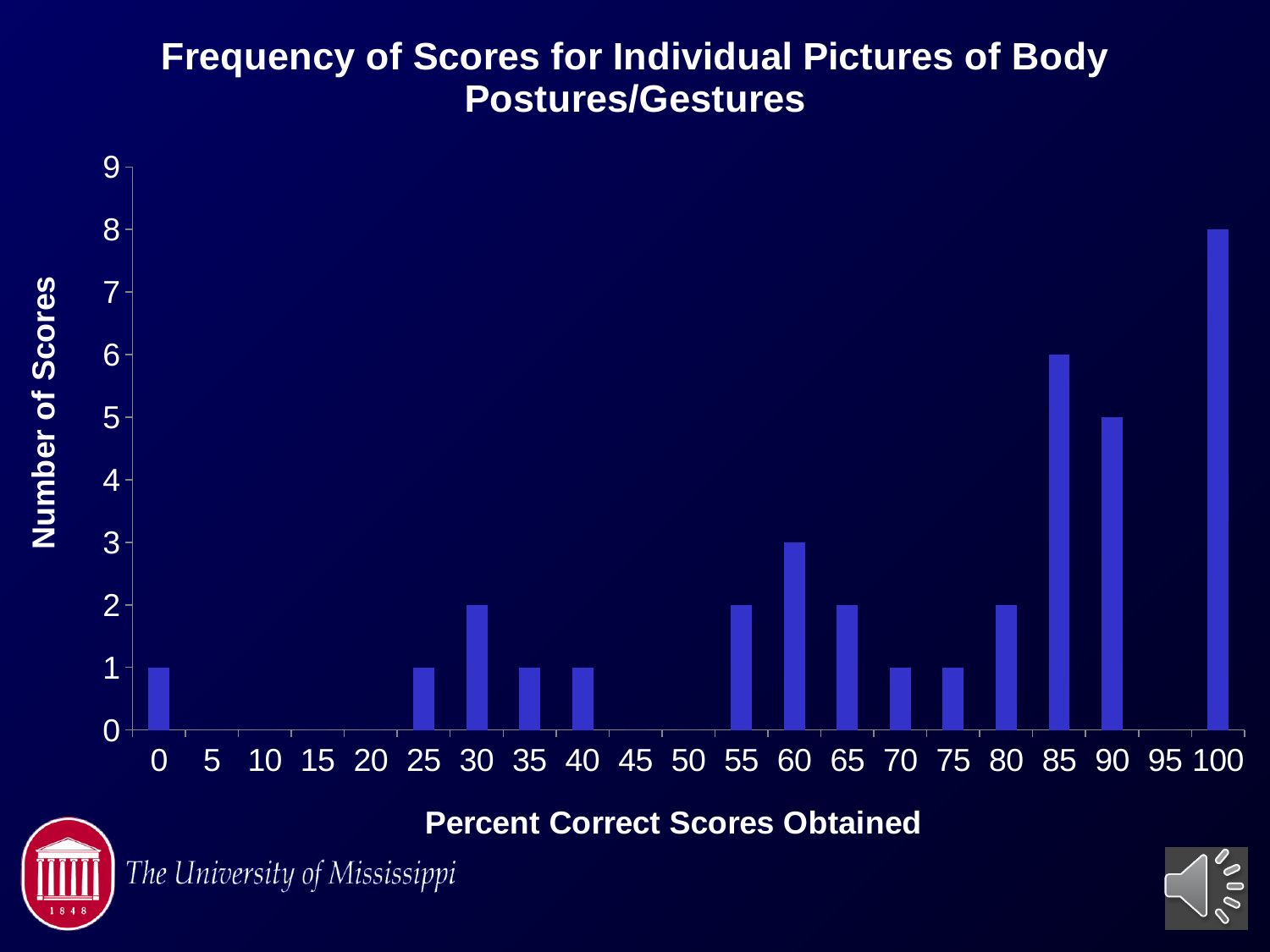
Which percent correct score has the highest number of scores? 100 Which has more scores, the 85 percent correct category or the 90 percent correct category? 85 What is the number of scores for the 100 percent correct category? 8 What is the number of scores for the 90 percent correct category? 5 What is the title of the chart? Frequency of Scores for Individual Pictures of Body Postures/Gestures What is the label of the y axis? Number of Scores What is the number of scores for the 60 percent correct category? 3 What type of chart is shown on the slide? bar chart How many percent correct categories are labelled on the x axis? 21 What is the number of scores for the 85 percent correct category? 6 What is the difference in number of scores between the 100 and 85 percent correct categories? 2 Is the number of scores for the 100 percent correct category greater or less than 7? greater